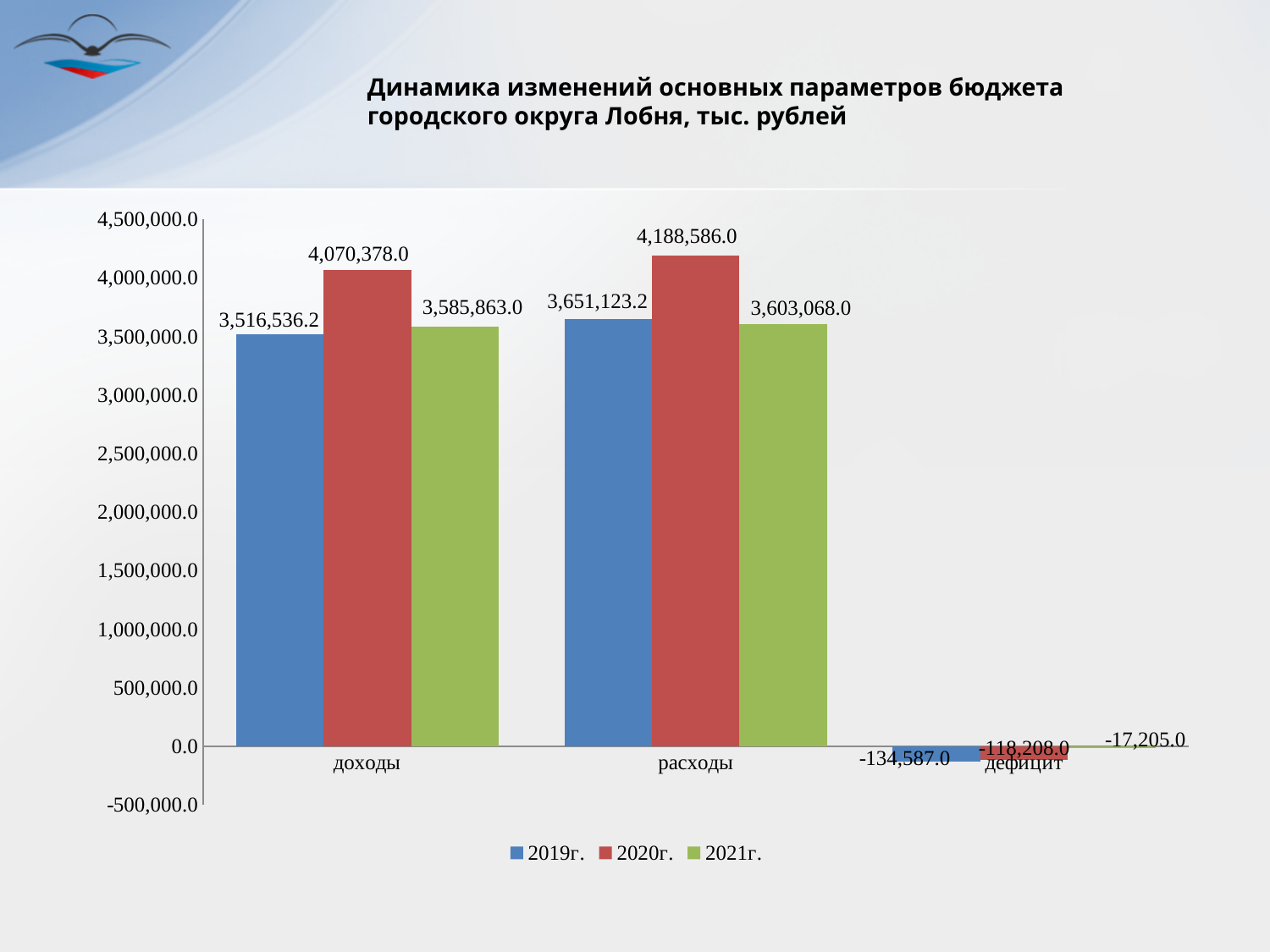
What is the value for доходы in the 2020г. series? 4,070,378.0 Which series has the lowest value for доходы? 2019г. Which colour represents the 2021г. series in the legend? green How many series does the legend list? 3 Which series has the highest value for расходы? 2020г. Which is larger in the 2021г. series: доходы or расходы? расходы What is the value for расходы in the 2019г. series? 3,651,123.2 Is the value for расходы in the 2020г. series greater or less than 4,000,000.0? greater What kind of chart is shown on the slide? bar chart What is the value for дефицит in the 2021г. series? -17,205.0 How many categories are shown on the x axis? 3 What is the difference between расходы and доходы in the 2020г. series? 118,208.0